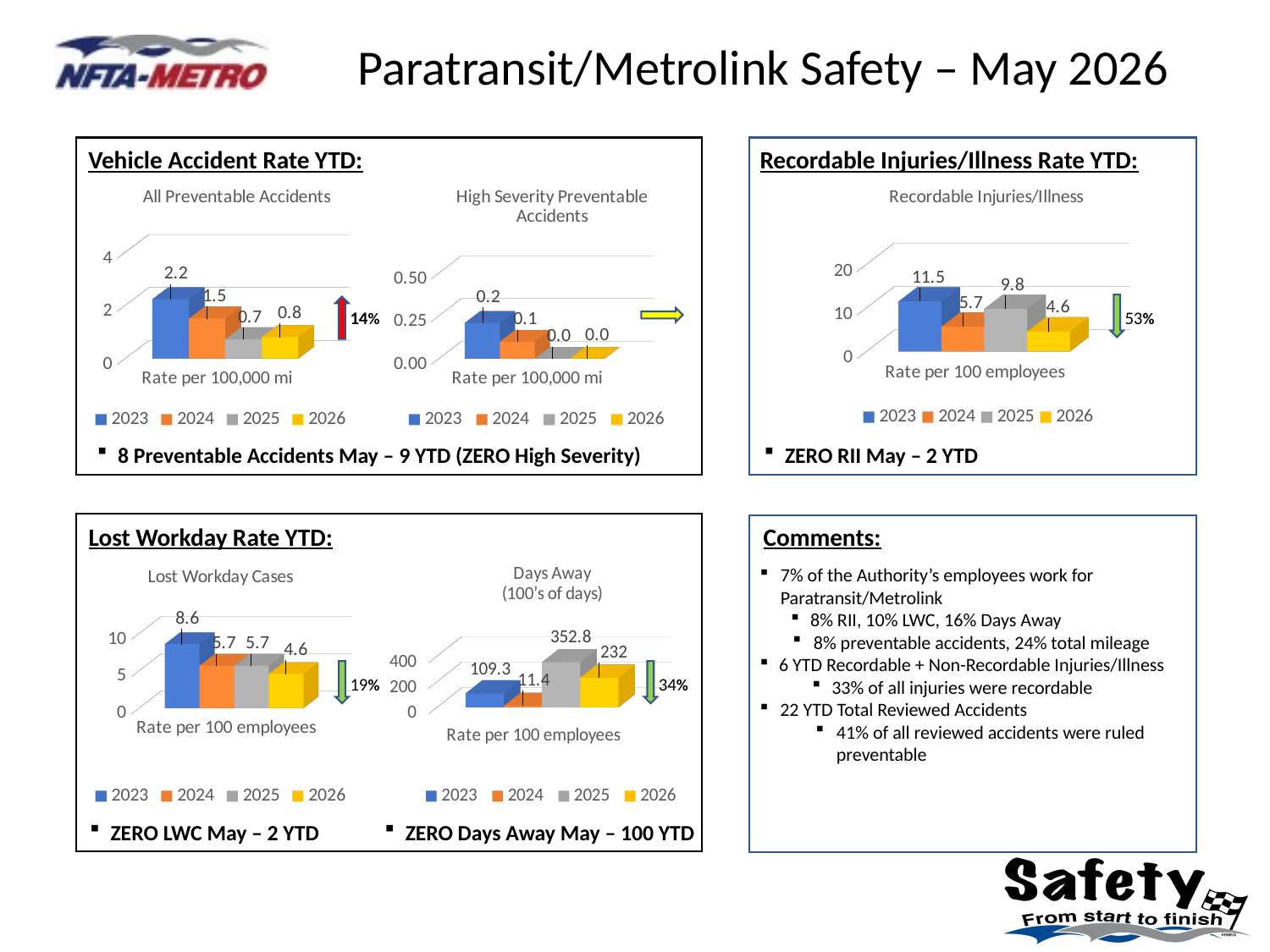
In the "Days Away" chart, which year has the highest value? 2025 In the "Lost Workday Cases" chart, is the value for 2023 greater or less than 5? greater In the "All Preventable Accidents" chart, what is the value for 2023? 2.2 In the "Days Away" chart, which is larger, the value for 2023 or the value for 2026? 2026 What kind of chart is the "Lost Workday Cases" chart? bar chart In the "Recordable Injuries/Illness" chart, what is the difference between the 2023 and 2026 values? 6.9 How many series does the legend of the "Days Away" chart list? 4 In the "Recordable Injuries/Illness" chart, which year has the highest value? 2023 In the "High Severity Preventable Accidents" chart, what is the value for 2024? 0.1 In the "Recordable Injuries/Illness" chart, what is the value for 2026? 4.6 In the "All Preventable Accidents" chart, which year has the lowest value? 2025 In the "Lost Workday Cases" chart, what is the value for 2023? 8.6